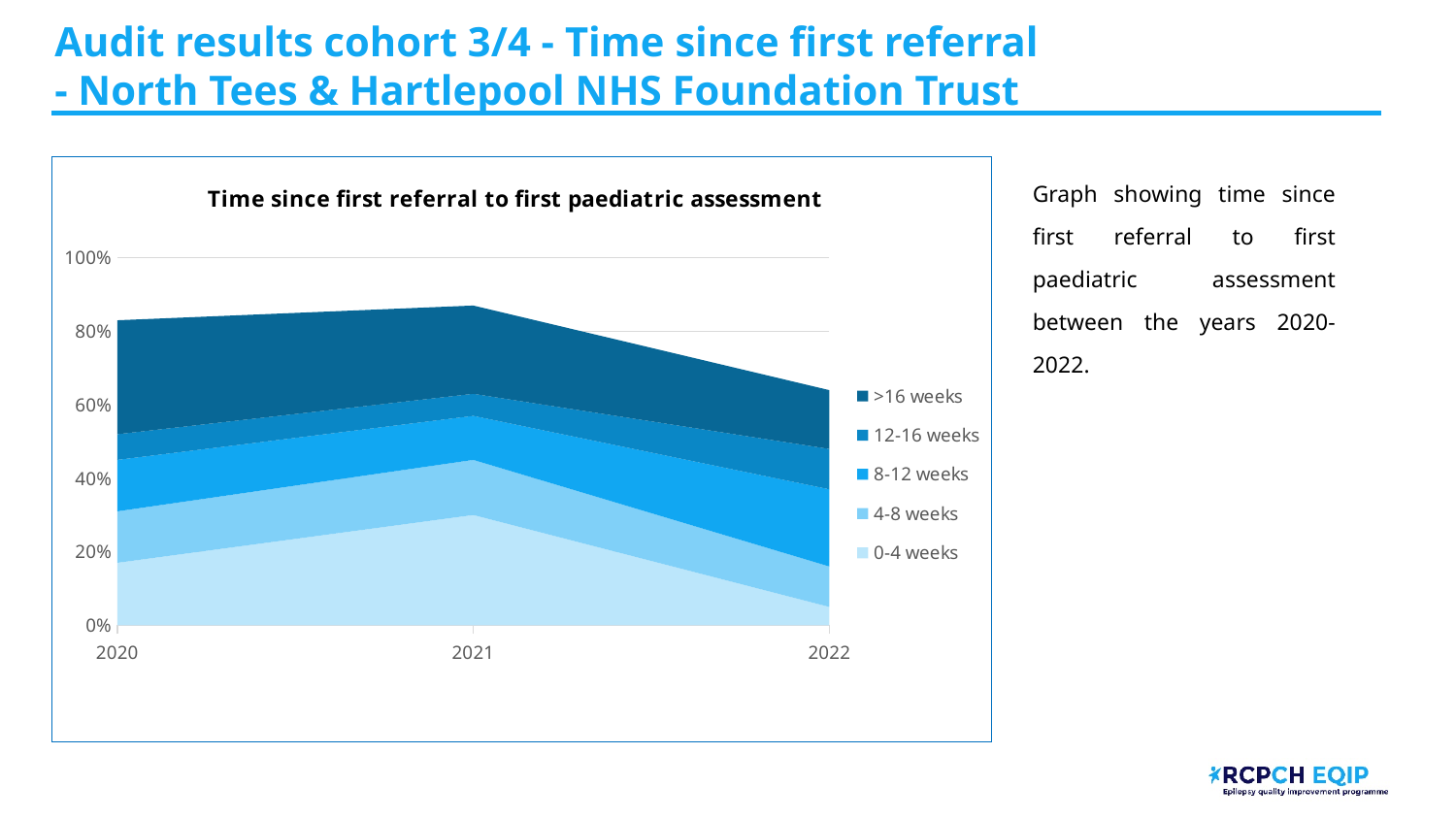
Which year has the highest 0-4 weeks value? 2021 What kind of chart is shown on the slide? Stacked area chart Is the 0-4 weeks value for 2021 greater or less than 20%? greater Is the total stacked value for 2021 greater or less than 80%? greater How many series does the chart's legend list? 5 Is the total stacked value for 2022 greater or less than 80%? less How many years are shown along the x axis of the chart? 3 Which series is listed first (at the top) in the chart's legend? >16 weeks Does the total stacked value rise or fall from 2021 to 2022? fall What is the title of the chart? Time since first referral to first paediatric assessment Which year has the lowest total stacked value? 2022